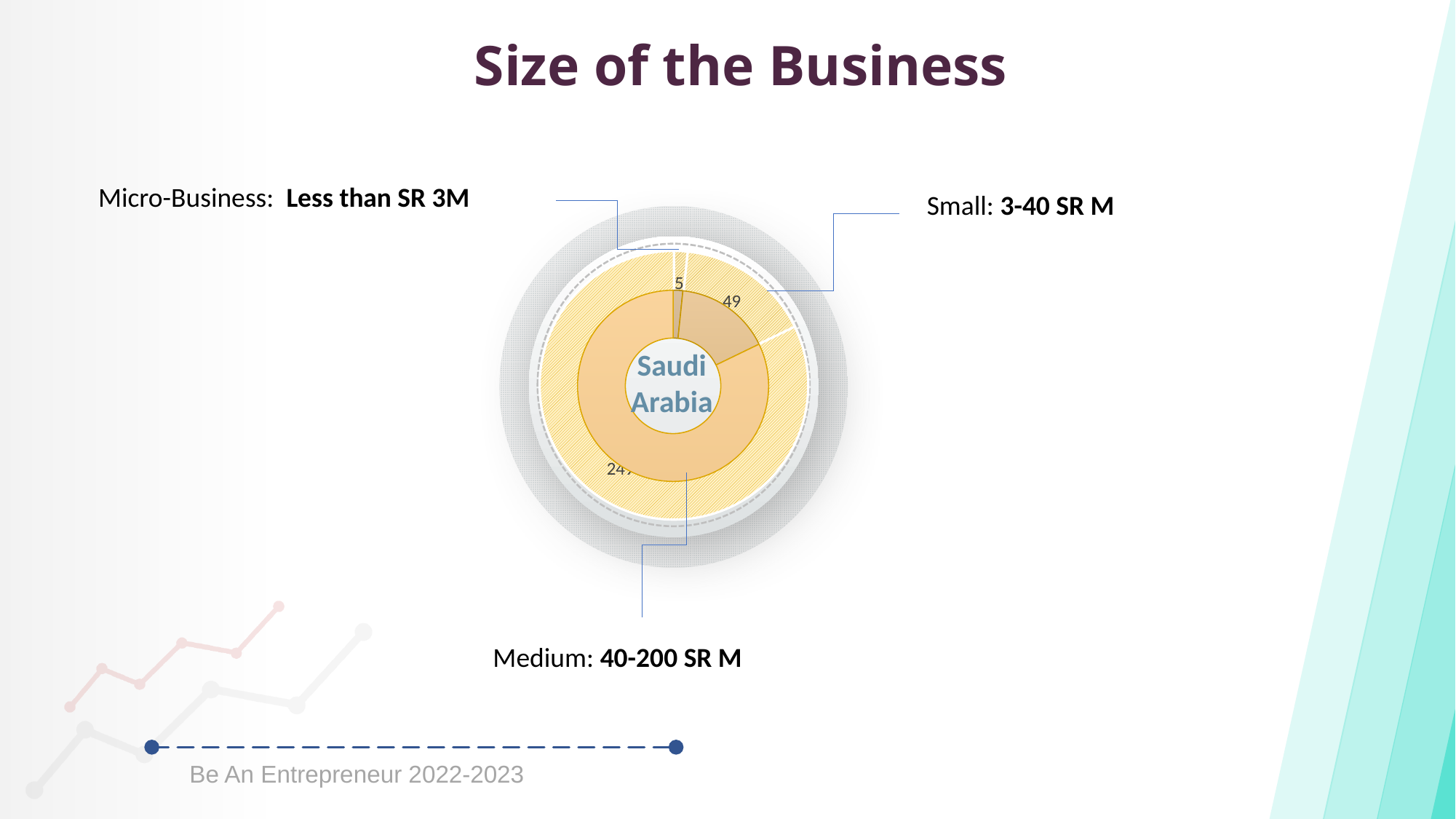
What kind of chart is shown on the slide? Doughnut chart How many slices does the pie chart have? 3 What text appears in the centre of the pie chart? Saudi Arabia What is the difference between the Small value and the Micro-Business value? 44 Which business size category has the smallest slice of the pie? Micro-Business Which is larger, the value for Small or the value for Micro-Business? Small Which business size category has the largest slice of the pie? Medium What is the title of the slide containing the chart? Size of the Business What value is shown for the Micro-Business (Less than SR 3M) slice? 5 What value is shown for the Small (3-40 SR M) slice? 49